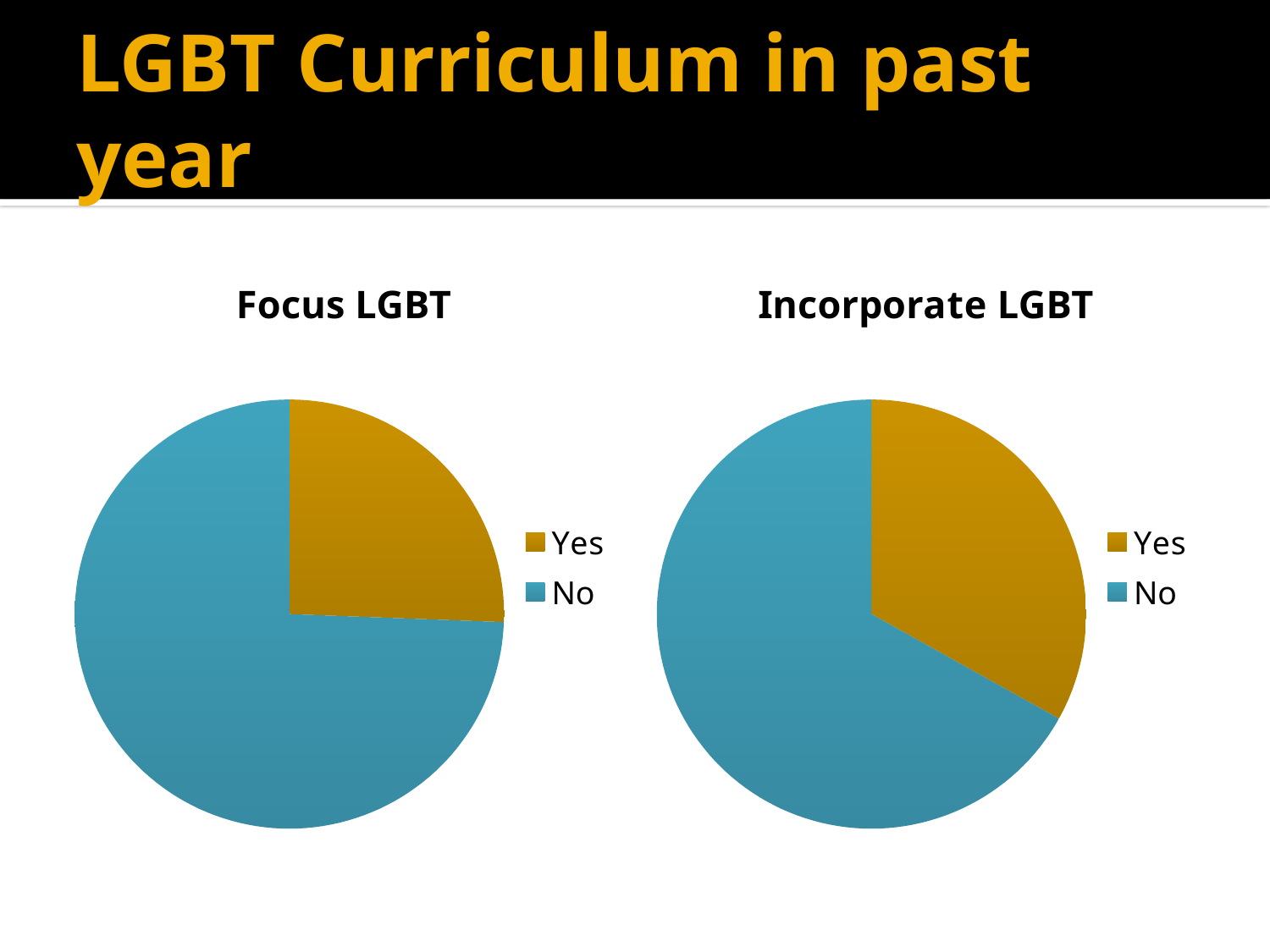
What is the title of the chart on the left of the slide? Focus LGBT In the "Incorporate LGBT" chart, which slice is the largest? No In the "Focus LGBT" chart, which slice is the smallest? Yes How many slices does the "Focus LGBT" pie chart have? 2 How many entries does the legend of the "Incorporate LGBT" chart list? 2 What kind of chart is the "Incorporate LGBT" chart? pie chart In the "Focus LGBT" chart, which slice is the largest? No What kind of chart is the "Focus LGBT" chart? pie chart In the "Incorporate LGBT" chart, which slice is the smallest? Yes In the "Focus LGBT" chart, is the "Yes" slice larger or smaller than the "No" slice? smaller Which chart has the larger "Yes" slice, "Focus LGBT" or "Incorporate LGBT"? Incorporate LGBT What colour is the "No" slice in the "Incorporate LGBT" chart? blue